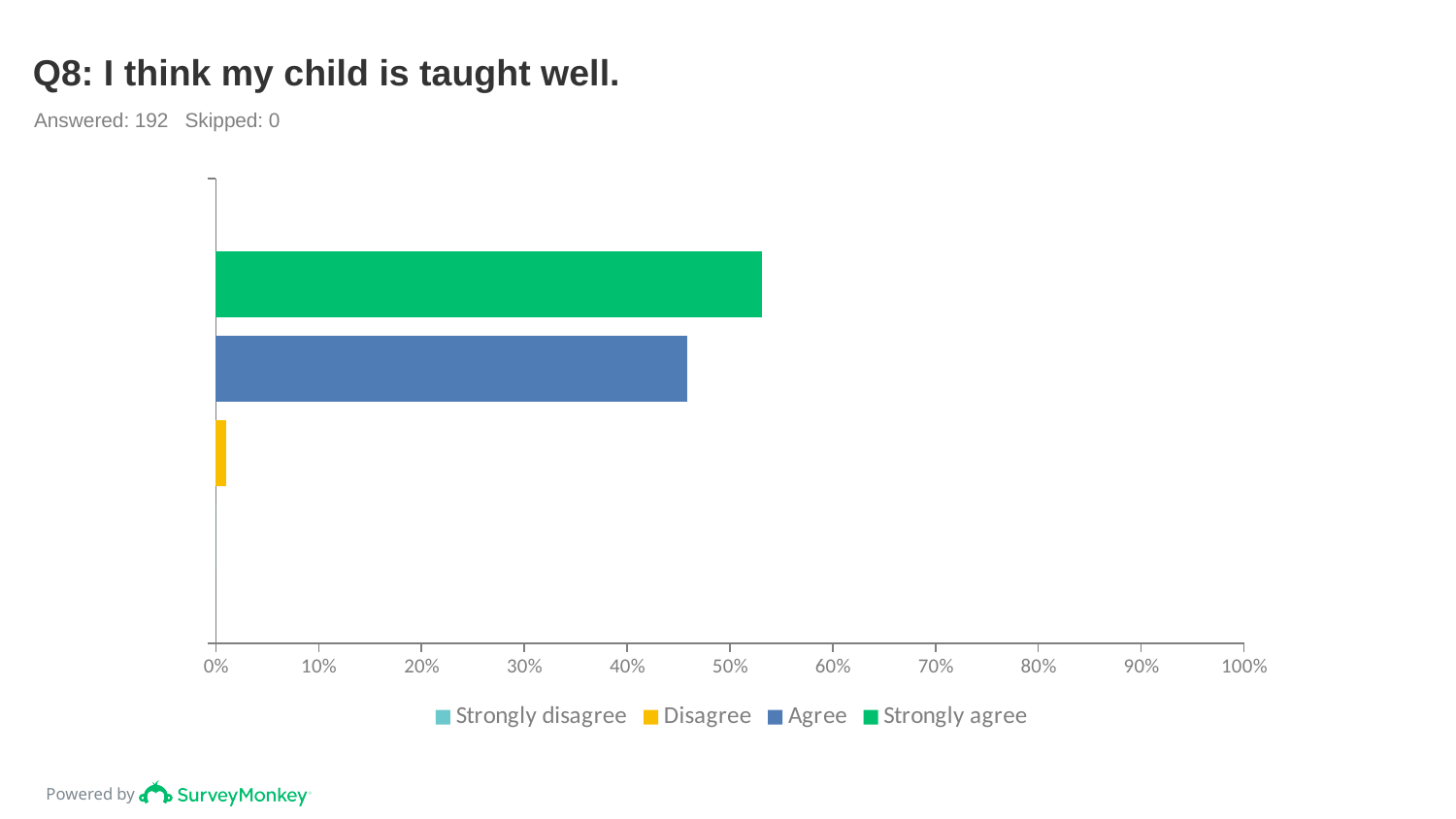
Is the value for Strongly agree greater or less than 60%? less Is the value for Agree greater or less than 40%? greater Is the value for Strongly agree greater or less than 50%? greater What kind of chart is shown on the slide? bar chart Which is larger, the value for Strongly agree or the value for Agree? Strongly agree Which is larger, the value for Agree or the value for Disagree? Agree How many series does the legend list? 4 Which response has the longest bar? Strongly agree How many respondents answered this question according to the slide? 192 What is the title of the chart? Q8: I think my child is taught well.